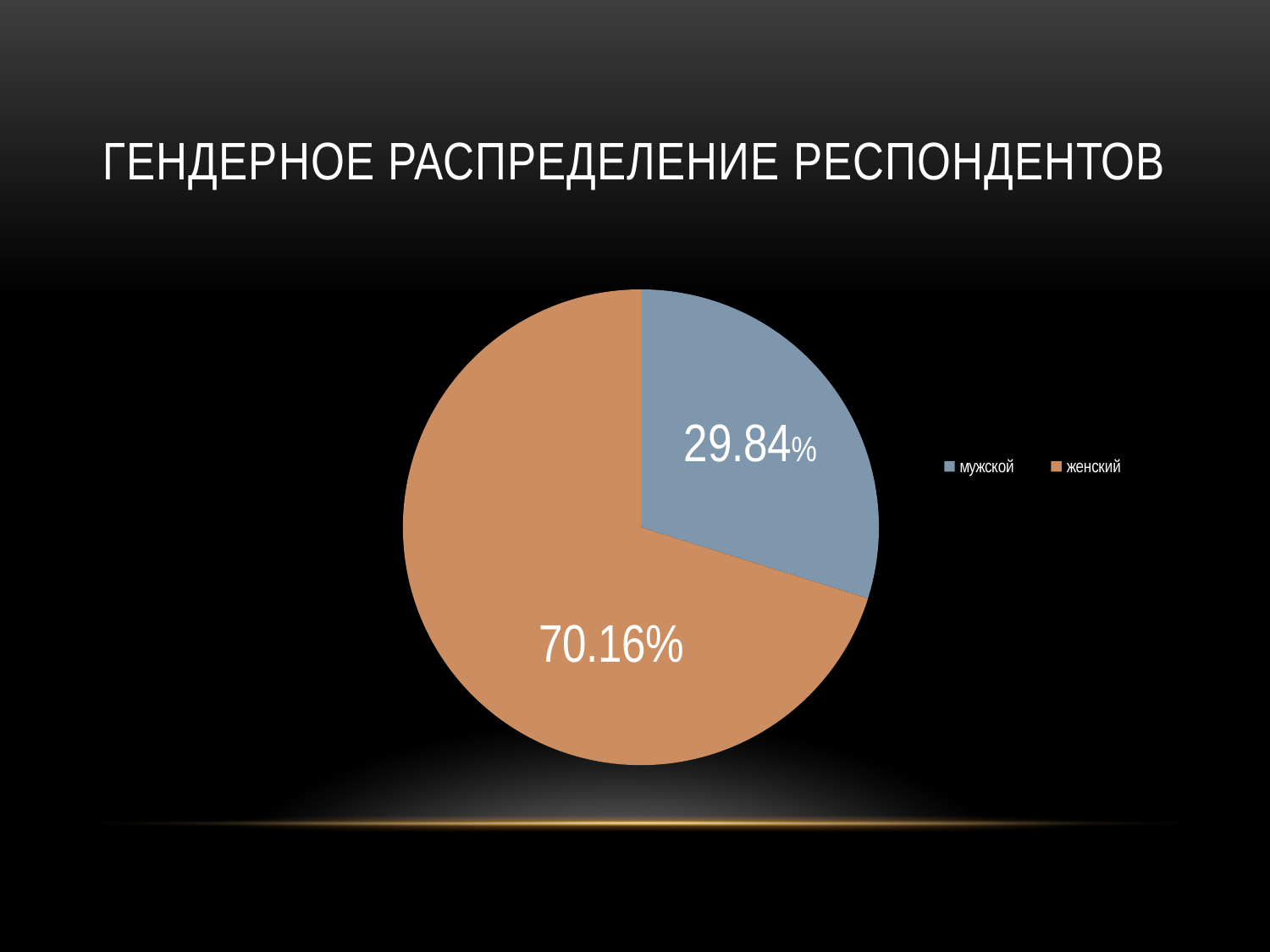
What colour is the slice for женский? orange What kind of chart is shown on the slide? pie chart What is the value for мужской? 29.84% What is the value for женский? 70.16% Which category has the smallest share of the pie? мужской Which category has the largest share of the pie? женский What is the title of the slide? ГЕНДЕРНОЕ РАСПРЕДЕЛЕНИЕ РЕСПОНДЕНТОВ How many entries does the legend list? 2 Which is larger, the share for мужской or the share for женский? женский What is the difference between the shares for женский and мужской? 40.32% How many categories does the pie chart have? 2 What share of the pie does the мужской slice represent? 29.84%